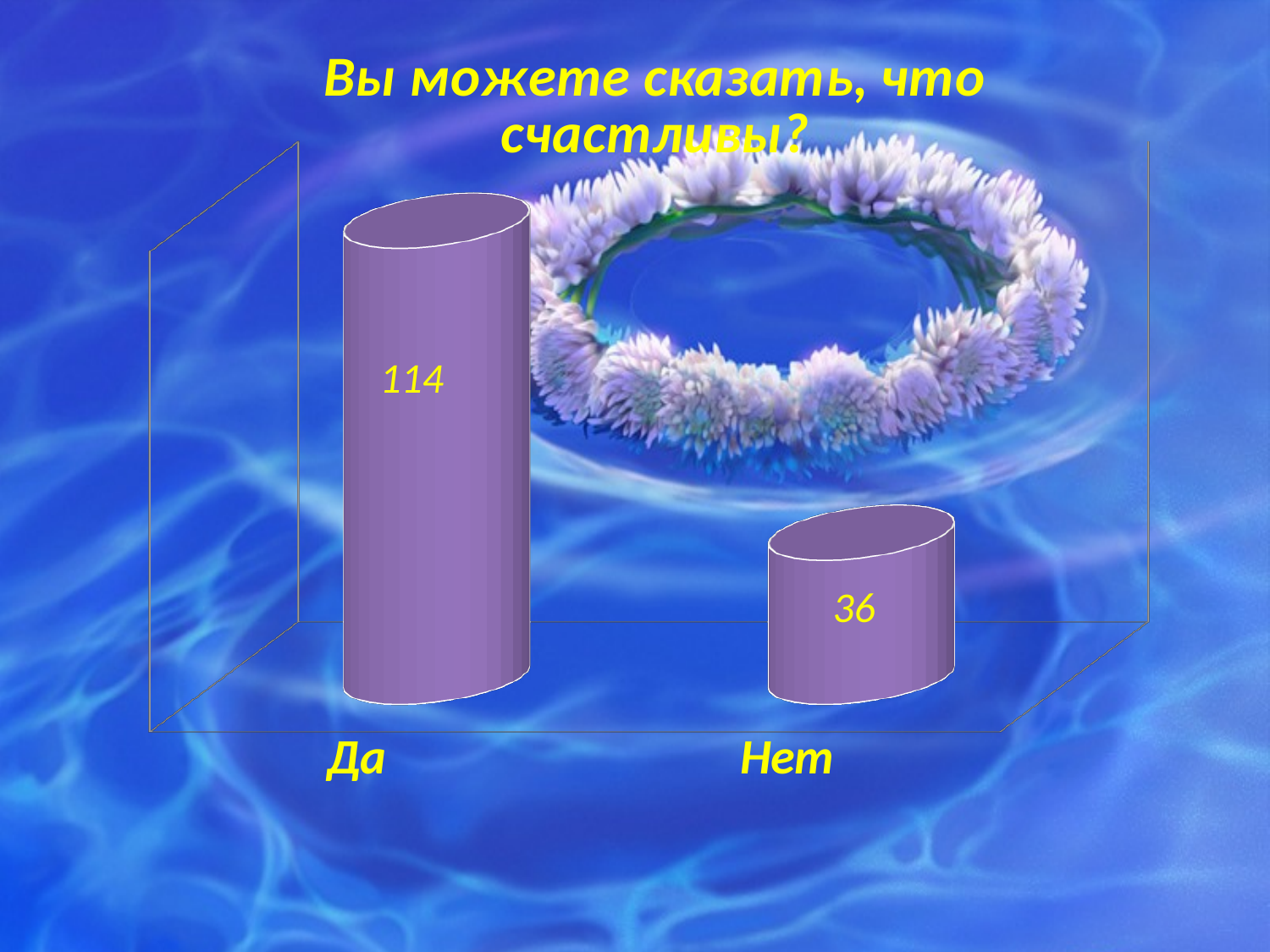
What kind of chart is shown on the slide? Bar chart How many categories are shown in the chart? 2 What is the value for "Да"? 114 What is the title of the chart? Вы можете сказать, что счастливы? What is the total of the two values shown in the chart? 150 Which category has the highest value? Да What is the value for "Нет"? 36 Which category has the lowest value? Нет What colour are the bars in the chart? Purple Which is larger, the value for "Да" or the value for "Нет"? Да What is the difference between the values for "Да" and "Нет"? 78